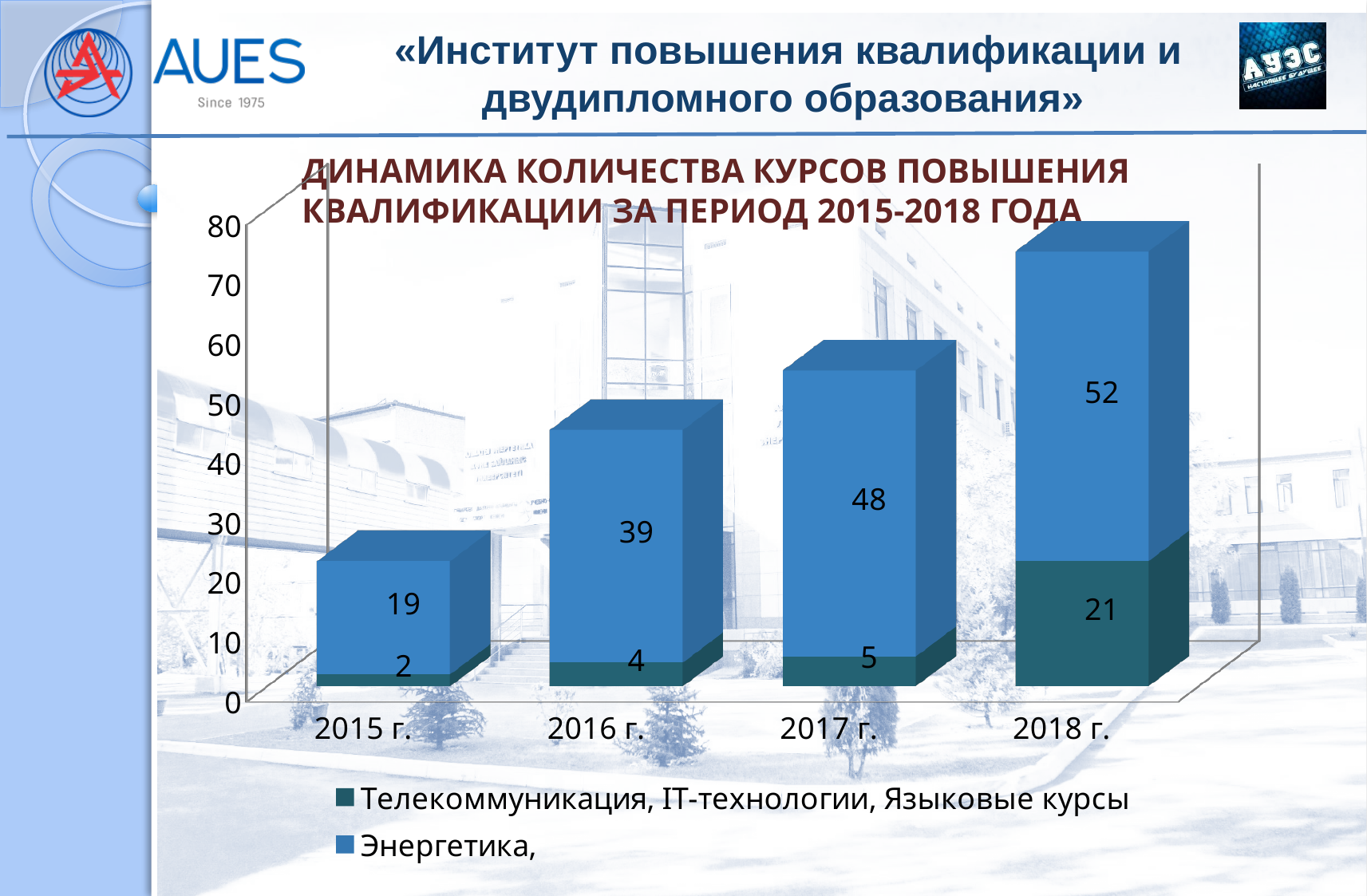
Which year has the lowest value for Телекоммуникация, IT-технологии, Языковые курсы? 2015 г. What is the value for Телекоммуникация, IT-технологии, Языковые курсы in 2018 г.? 21 What is the value for Энергетика in 2017 г.? 48 What kind of chart is shown on the slide? Stacked bar chart How many years are shown on the x axis? 4 Which is larger: the Телекоммуникация, IT-технологии, Языковые курсы value for 2018 г. or for 2017 г.? 2018 г. What is the difference between the Энергетика values for 2016 г. and 2015 г.? 20 What is the total of the stacked bar for 2018 г.? 73 How many series does the legend list? 2 Which year has the highest value for Энергетика? 2018 г. What is the value for Энергетика in 2015 г.? 19 What is the total of the stacked bar for 2016 г.? 43